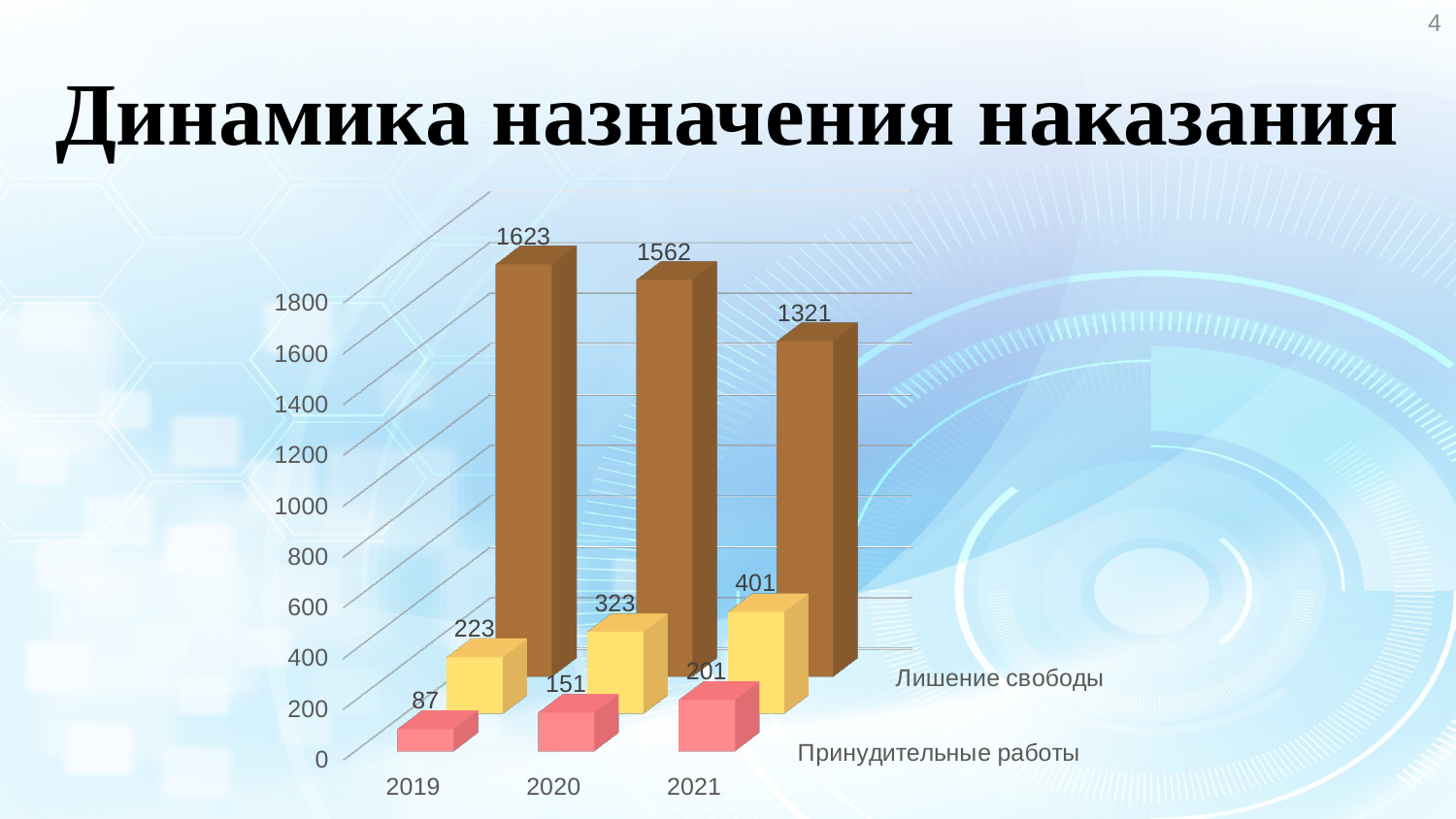
How many years are shown on the x axis of the chart? 3 Do the values for Принудительные работы rise or fall from 2019 to 2021? rise In which year is the value for Лишение свободы the highest? 2019 Which year has the larger value for Принудительные работы, 2020 or 2021? 2021 What is the value for Лишение свободы in 2019? 1623 What is the difference between the Принудительные работы values for 2021 and 2019? 114 What is the value for Лишение свободы in 2021? 1321 Do the values for Лишение свободы rise or fall from 2019 to 2021? fall What is the value for Принудительные работы in 2021? 201 What is the difference between the Лишение свободы values for 2019 and 2021? 302 In which year is the value for Принудительные работы the lowest? 2019 What is the value for Принудительные работы in 2019? 87